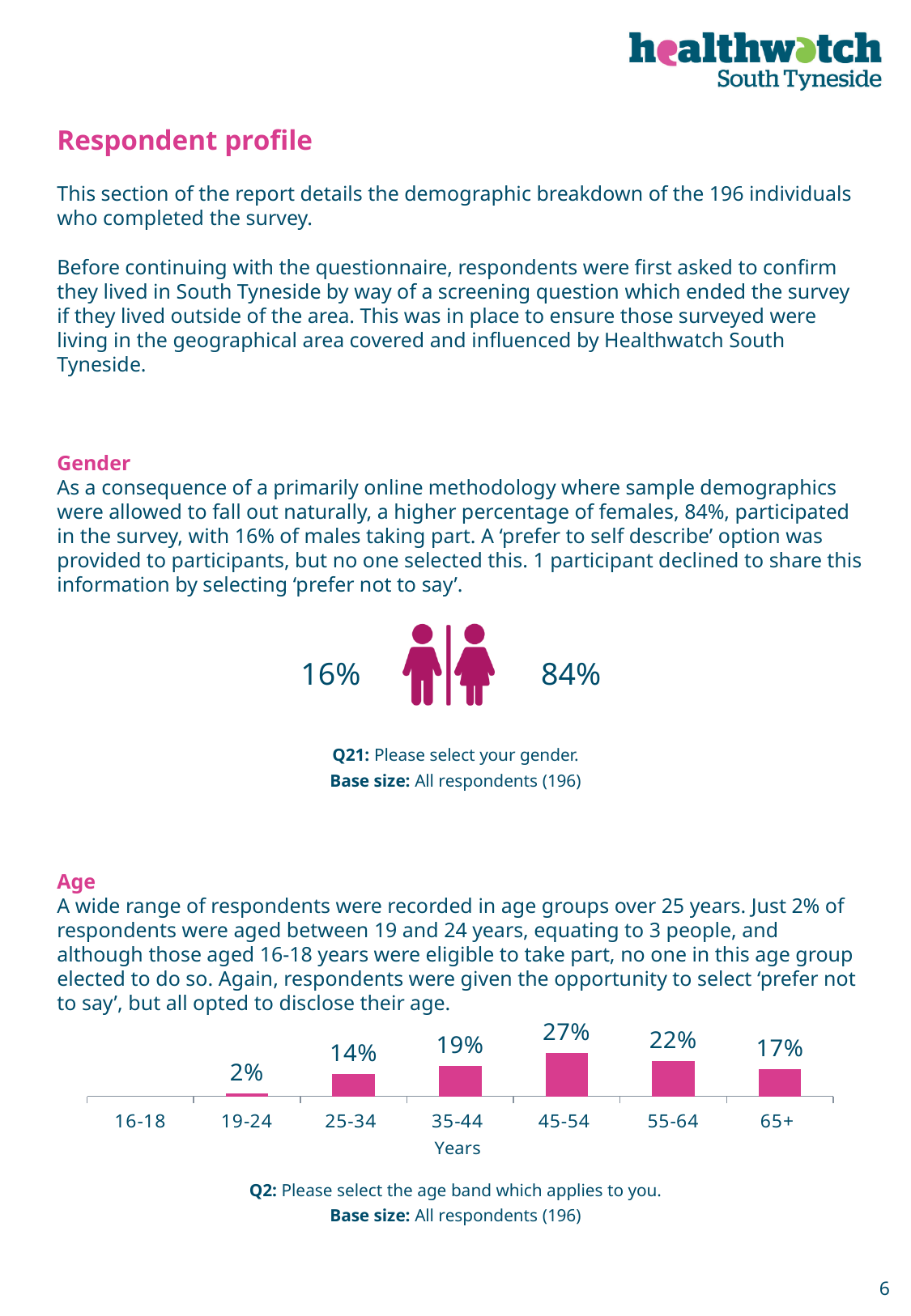
In the age bar chart, what percentage of respondents were aged 45-54? 27% In the gender infographic, what percentage of respondents were female? 84% In the age bar chart, what percentage of respondents were aged 19-24? 2% In the age bar chart, which labelled age band with a bar has the lowest percentage of respondents? 19-24 What is the x-axis title of the age bar chart? Years In the gender infographic, what percentage of respondents were male? 16% In the age bar chart, what is the difference in percentage points between the 45-54 and 55-64 age bands? 5 In the age bar chart, which age band has the highest percentage of respondents? 45-54 What type of chart is used to show the age breakdown of respondents? Bar chart How many age bands are shown on the x axis of the age bar chart? 7 In the age bar chart, what percentage of respondents were aged 65+? 17% In the age bar chart, which age band has a larger share of respondents, 25-34 or 35-44? 35-44